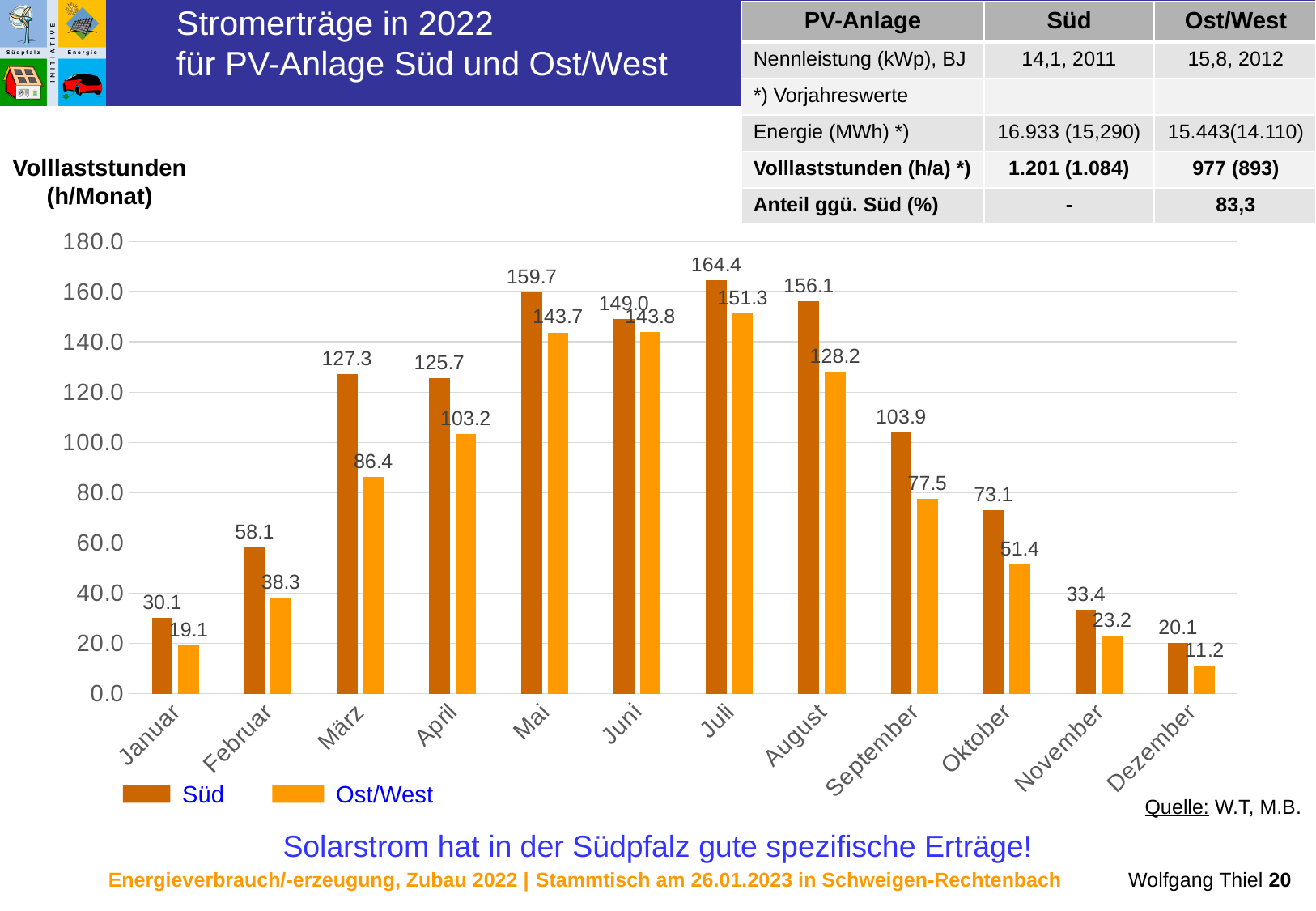
What is the difference between the Süd and Ost/West values for März? 40.9 What is the Ost/West value for April? 103.2 What is the Süd value for Juli? 164.4 How many months are shown on the x axis? 12 What is the Süd value for Oktober? 73.1 How many series does the legend list? 2 Which month has the lowest Süd value? Dezember What kind of chart is shown on the slide? bar chart Which month has the highest Ost/West value? Juli What unit is given for the y axis of the chart? h/Monat Do the Süd values rise or fall from August to Dezember? fall Which is larger, the Süd value for Mai or the Süd value for August? Mai